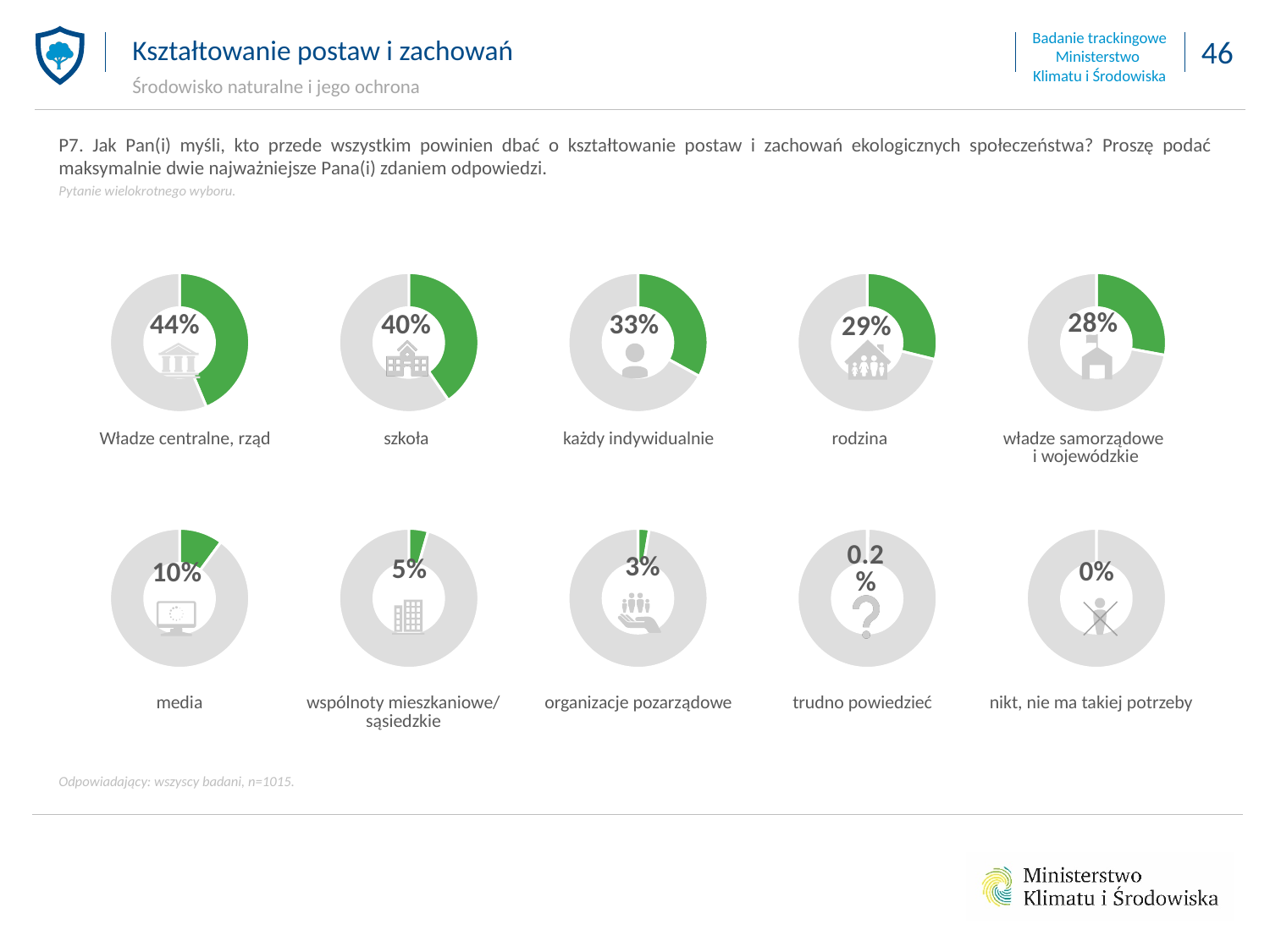
What value is shown in the donut chart labelled "media"? 10% What value is shown in the donut chart labelled "rodzina"? 29% What value is shown in the donut chart labelled "Władze centralne, rząd"? 44% What value is shown in the donut chart labelled "trudno powiedzieć"? 0.2% What value is shown in the donut chart labelled "władze samorządowe i wojewódzkie"? 28% Which is larger: the value in the "rodzina" chart or the value in the "władze samorządowe i wojewódzkie" chart? rodzina What value is shown in the donut chart labelled "szkoła"? 40% Across all the donut charts on the slide, which category has the highest value? Władze centralne, rząd How many donut charts are shown on the slide? 10 Across all the donut charts on the slide, which category has the lowest value? nikt, nie ma takiej potrzeby What is the difference between the value in the "szkoła" chart and the value in the "media" chart? 30% What value is shown in the donut chart labelled "każdy indywidualnie"? 33%